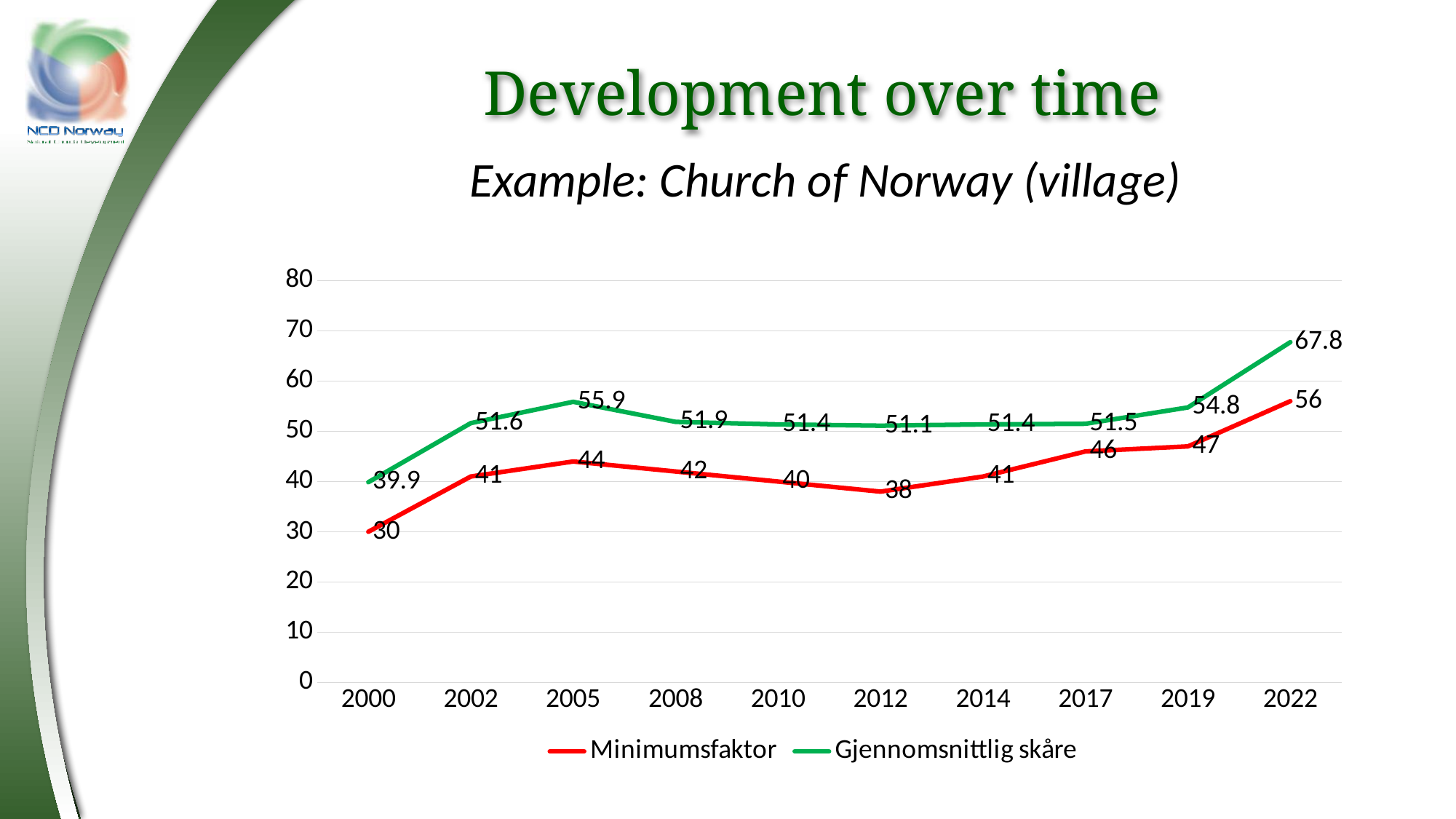
What is the Gjennomsnittlig skåre value for 2005? 55.9 Is the Gjennomsnittlig skåre for 2019 greater or less than 50? greater Which colour is used for the Minimumsfaktor line? red What is the Gjennomsnittlig skåre value for 2022? 67.8 How many years are shown on the x axis? 10 How many series does the legend list? 2 What is the Minimumsfaktor value for 2000? 30 In which year is the Minimumsfaktor lowest? 2000 Which is larger, the Minimumsfaktor in 2017 or the Minimumsfaktor in 2012? 2017 What kind of chart is shown on the slide? line chart In which year is the Gjennomsnittlig skåre highest? 2022 What is the difference between the Gjennomsnittlig skåre and the Minimumsfaktor in 2022? 11.8